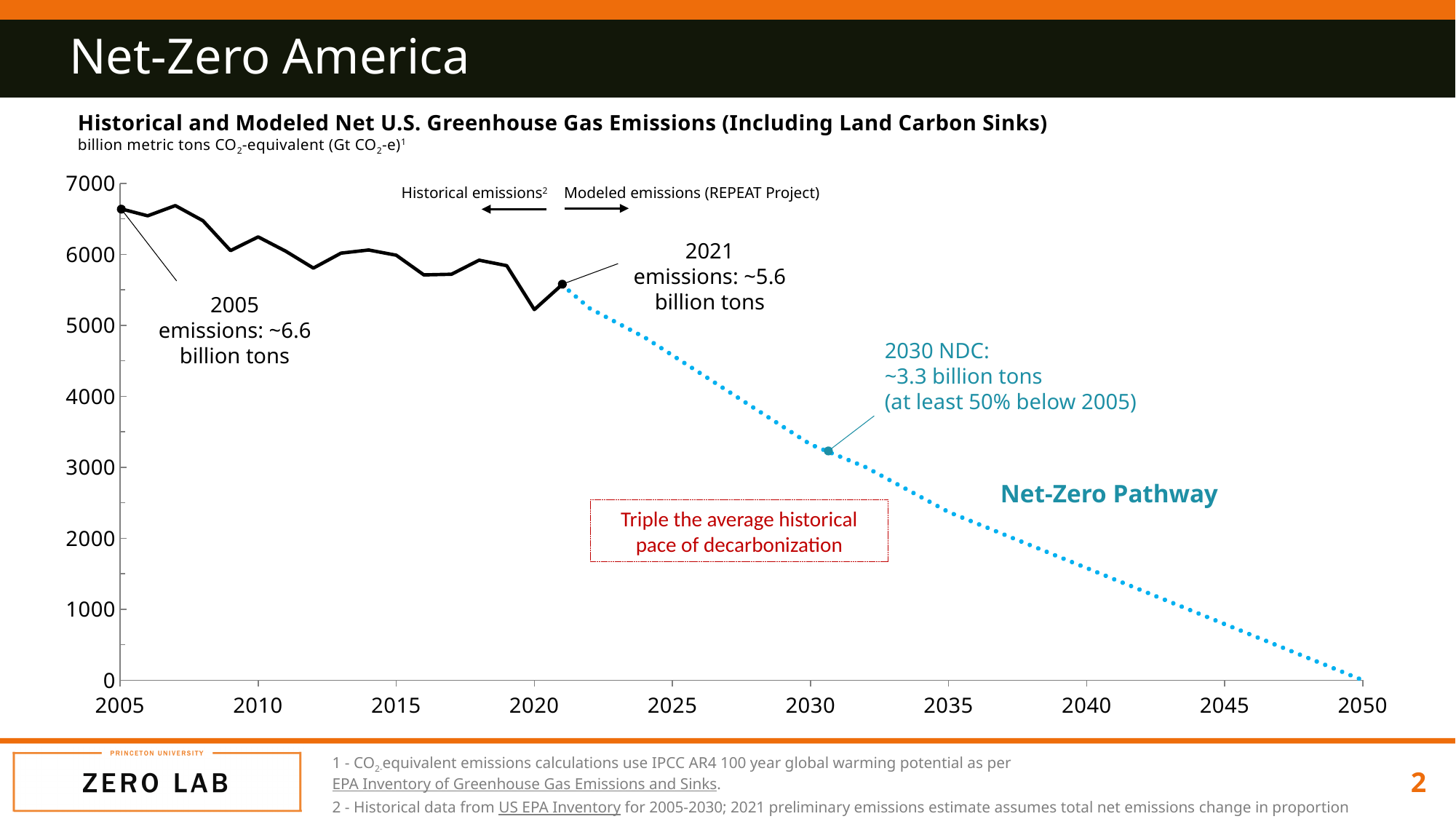
What 2030 NDC target is annotated on the chart? ~3.3 billion tons (at least 50% below 2005) What kind of chart is shown on the slide? line chart What emissions value does the Net-Zero Pathway reach in 2050? 0 Which year has higher emissions, 2020 or 2030? 2020 Do the emissions values rise or fall overall from 2005 to 2050? fall Is the emissions value for 2035 on the Net-Zero Pathway greater or less than 3000? less Is the emissions value for 2005 greater or less than 6000? greater Which year has higher emissions, 2005 or 2021? 2005 What is the title of the chart? Historical and Modeled Net U.S. Greenhouse Gas Emissions (Including Land Carbon Sinks) Is the emissions value for 2021 greater or less than 6000? less